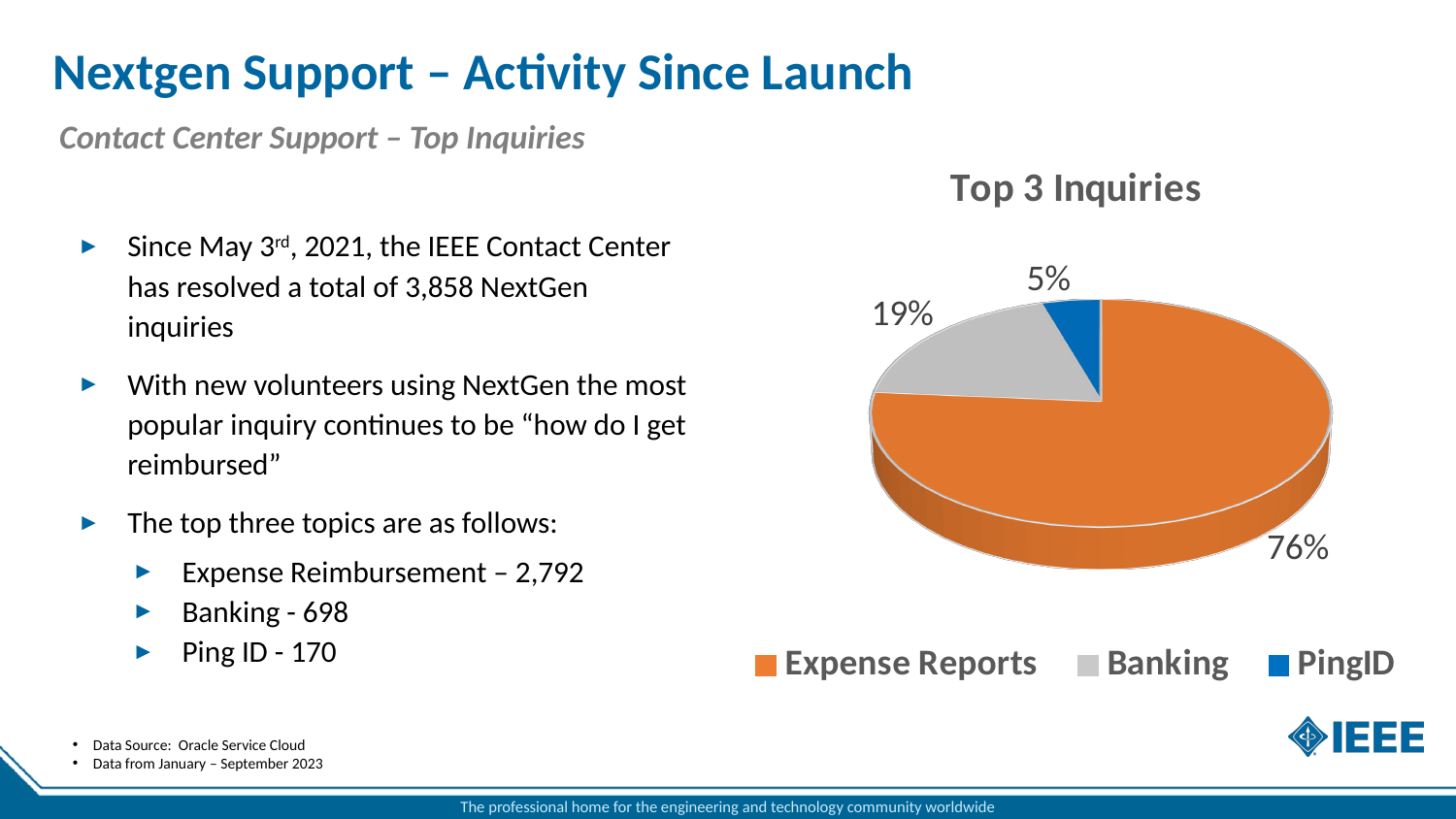
Which category has the smallest slice of the pie? PingID How many categories does the pie chart show? 3 What kind of chart is shown on the slide? pie chart Which slice is larger, Banking or PingID? Banking What is the title of the chart on the slide? Top 3 Inquiries What share of the pie does PingID have? 5% What is the difference in percentage points between the Banking slice and the PingID slice? 14 What share of the pie does Banking have? 19% What colour is the Expense Reports slice in the pie chart? orange What is the difference in percentage points between the Expense Reports slice and the Banking slice? 57 Which category has the largest slice of the pie? Expense Reports What share of the pie does Expense Reports have? 76%